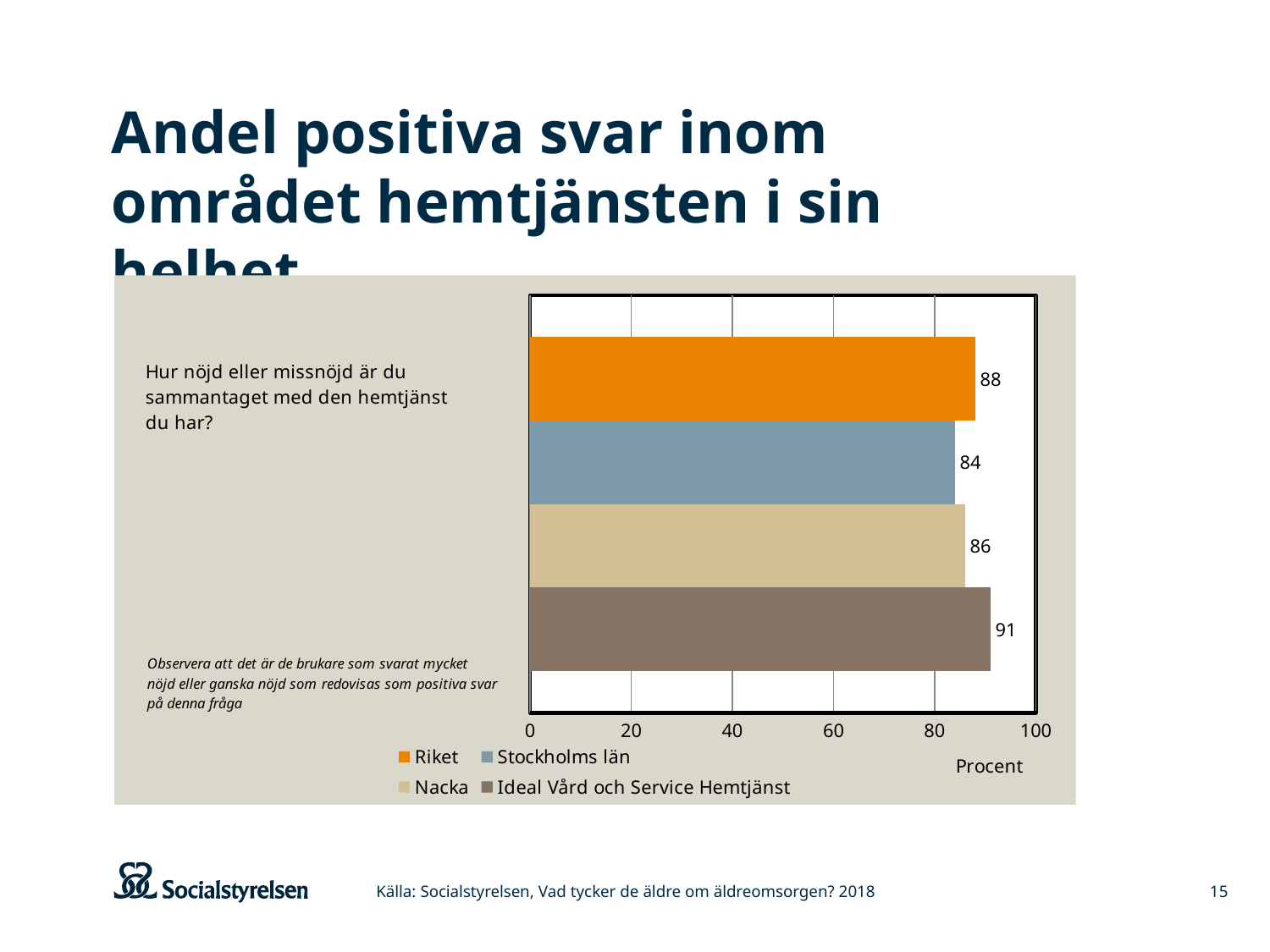
What is the label on the horizontal axis of the chart? Procent What is the value for Ideal Vård och Service Hemtjänst? 91 Which series has the lowest value? Stockholms län Which series has the highest value? Ideal Vård och Service Hemtjänst Which is larger, the value for Riket or the value for Nacka? Riket What is the value for Nacka? 86 Is the value for Stockholms län greater or less than 80? greater What is the value for Riket? 88 What is the value for Stockholms län? 84 What is the difference between the values for Ideal Vård och Service Hemtjänst and Stockholms län? 7 What kind of chart is shown on the slide? Bar chart How many series does the legend list? 4